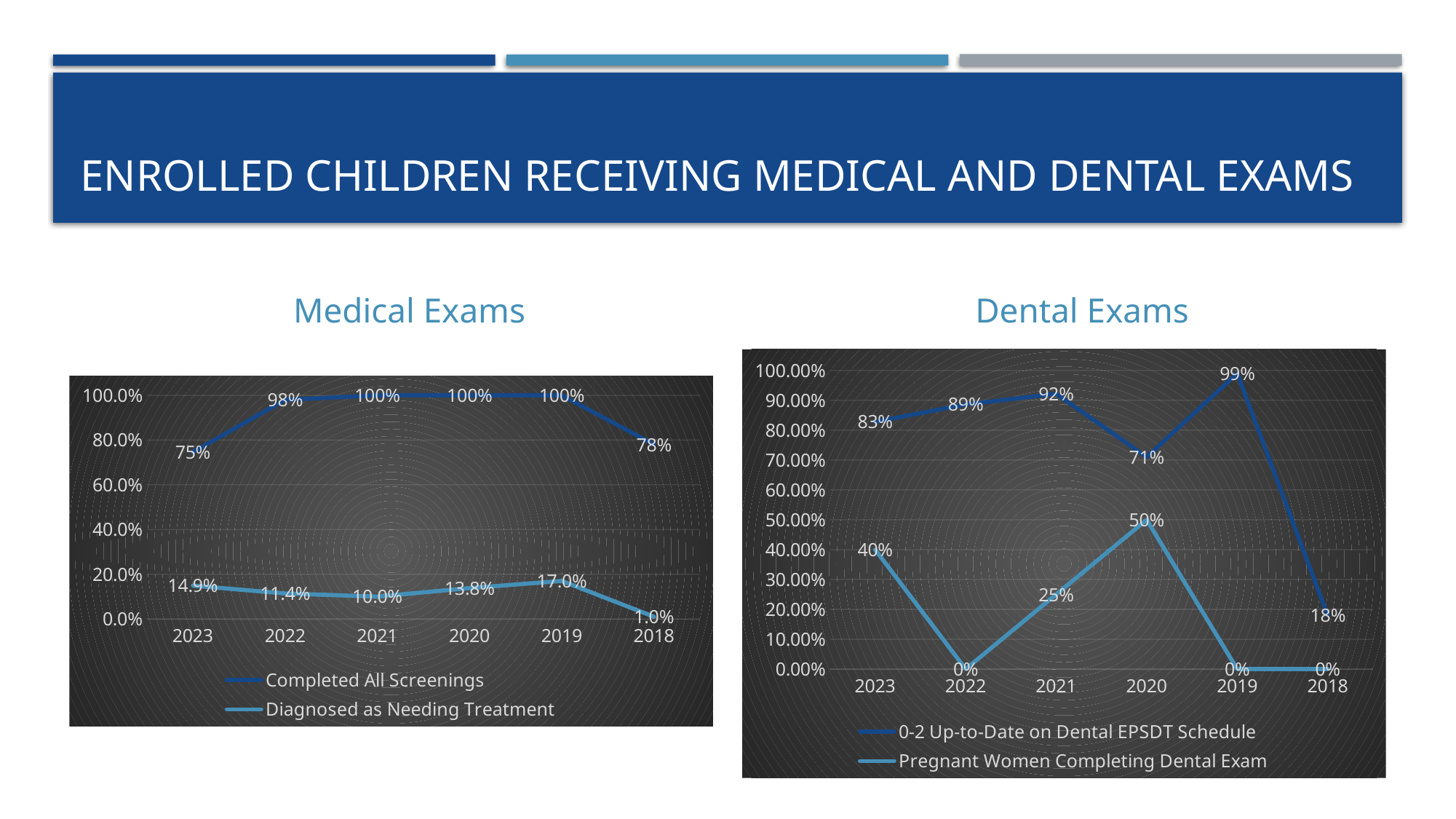
In the Dental Exams chart, what is the value for 0-2 Up-to-Date on Dental EPSDT Schedule in 2020? 71% In the Dental Exams chart, which year has the highest value for 0-2 Up-to-Date on Dental EPSDT Schedule? 2019 In the Dental Exams chart, which is larger in 2018: 0-2 Up-to-Date on Dental EPSDT Schedule or Pregnant Women Completing Dental Exam? 0-2 Up-to-Date on Dental EPSDT Schedule In the Dental Exams chart, what is the value for Pregnant Women Completing Dental Exam in 2021? 25% In the Medical Exams chart, which year has the lowest value for Diagnosed as Needing Treatment? 2018 In the Dental Exams chart, which year has the highest value for Pregnant Women Completing Dental Exam? 2020 In the Medical Exams chart, what is the value for Completed All Screenings in 2023? 75% What kind of chart is the Dental Exams chart? Line chart In the Medical Exams chart, what is the value for Diagnosed as Needing Treatment in 2019? 17.0% In the Medical Exams chart, what is the difference between Completed All Screenings in 2022 and in 2023? 23% In the Medical Exams chart, how many series does the legend list? 2 In the Dental Exams chart, how many years are shown on the x axis? 6